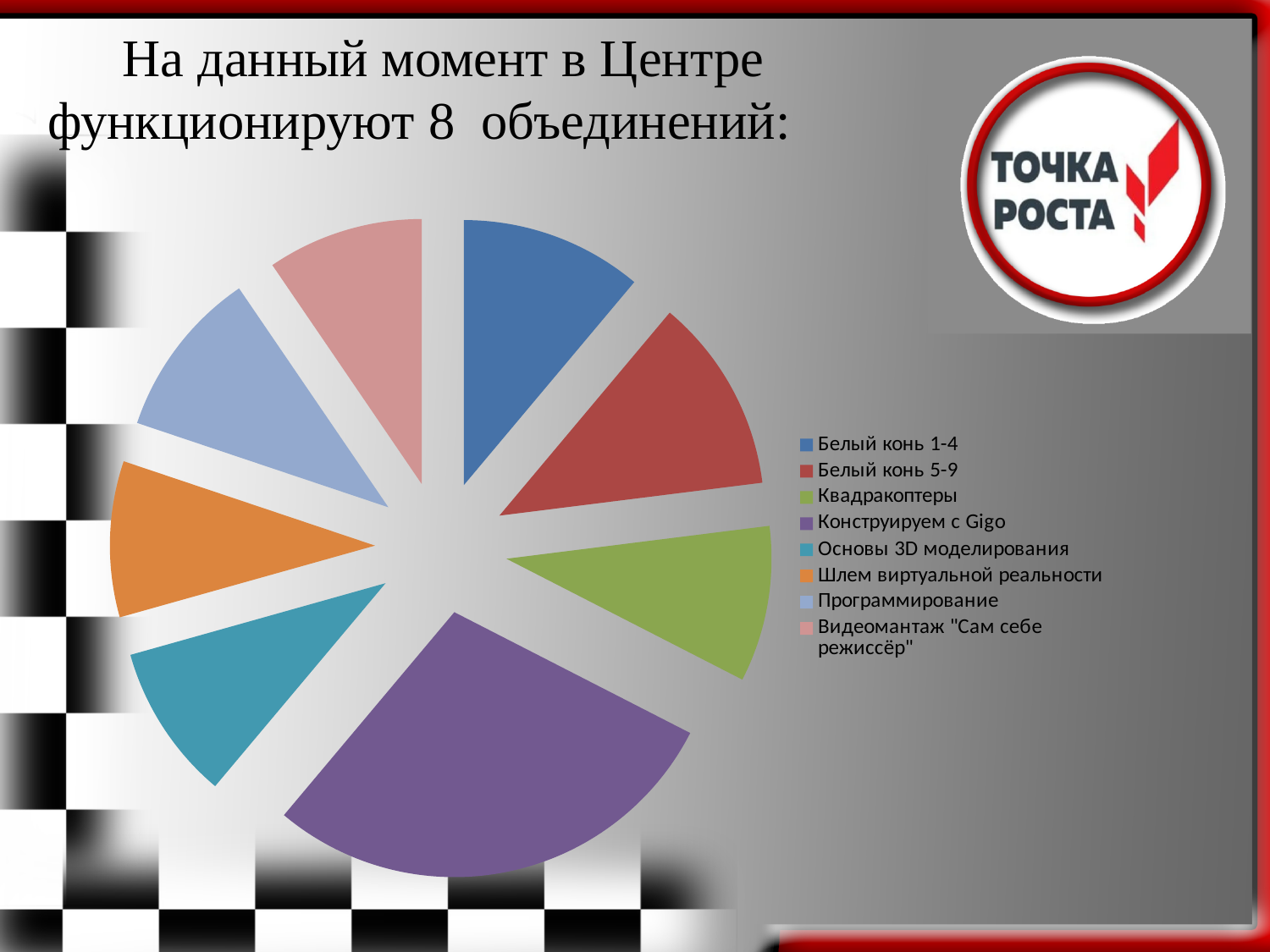
What colour is the slice for "Конструируем с Gigo" in the pie chart? purple Which slice is larger: "Конструируем с Gigo" or "Белый конь 1-4"? Конструируем с Gigo Which slice is larger: "Конструируем с Gigo" or "Квадракоптеры"? Конструируем с Gigo Which category has the largest slice in the pie chart? Конструируем с Gigo How many entries does the legend of the pie chart list? 8 How many slices does the pie chart have? 8 What kind of chart is shown on the slide? pie chart Which legend entry is listed first in the pie chart's legend? Белый конь 1-4